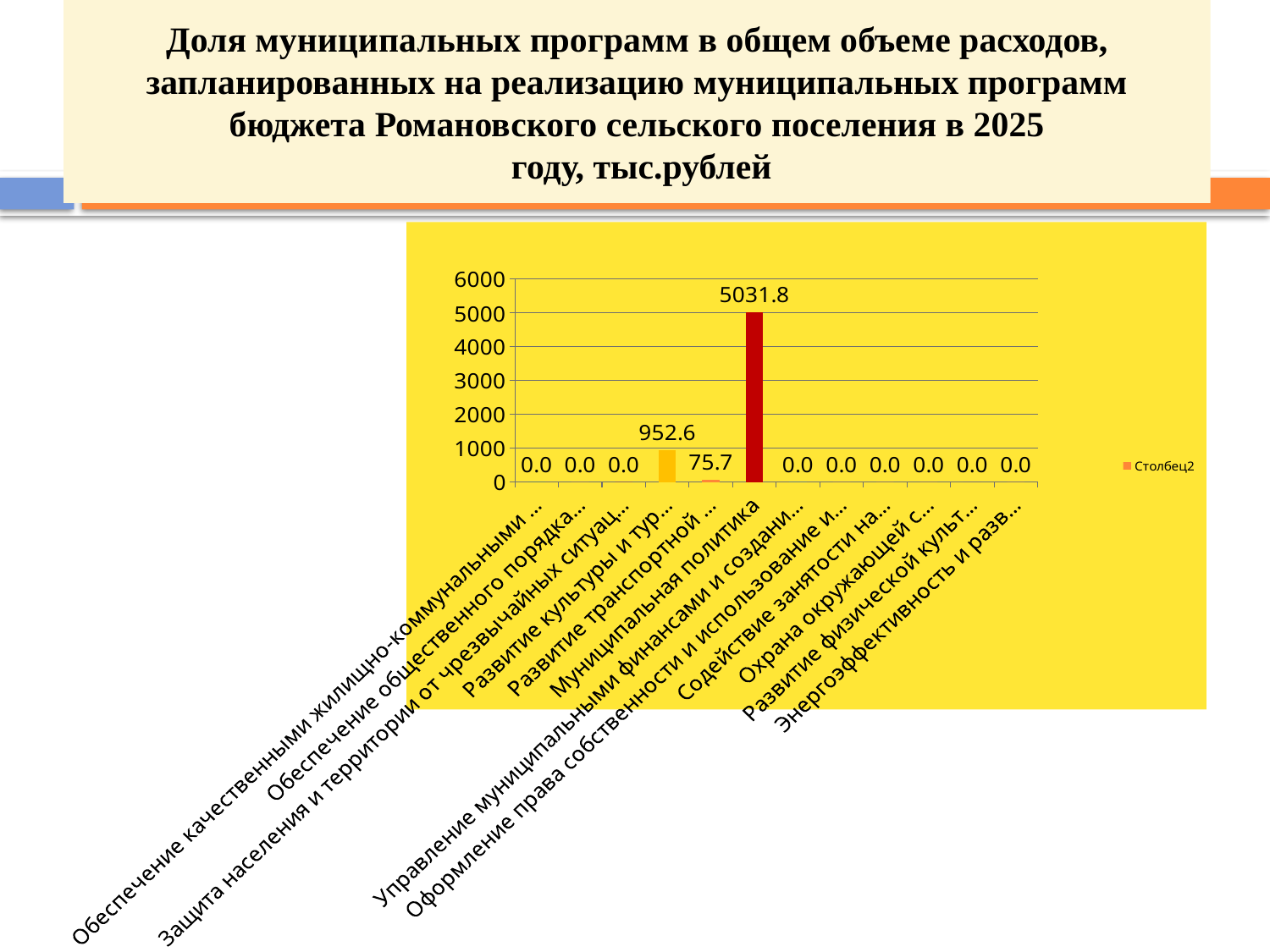
How many categories have a value of 0.0? 9 Which category has the highest value? Муниципальная политика What is the difference between the values for Муниципальная политика and "Развитие культуры и тур..."? 4079.2 What is the value for Муниципальная политика? 5031.8 How many categories are shown on the x axis? 12 What is the value for the category labelled "Развитие транспортной ..."? 75.7 What kind of chart is shown on the slide? bar chart What is the value for the category labelled "Развитие культуры и тур..."? 952.6 What is the difference between the values for "Развитие культуры и тур..." and "Развитие транспортной ..."? 876.9 Is the value for Муниципальная политика greater or less than 5000? greater How many series does the legend list? 1 Which is larger, the value for "Развитие культуры и тур..." or the value for "Развитие транспортной ..."? Развитие культуры и тур...